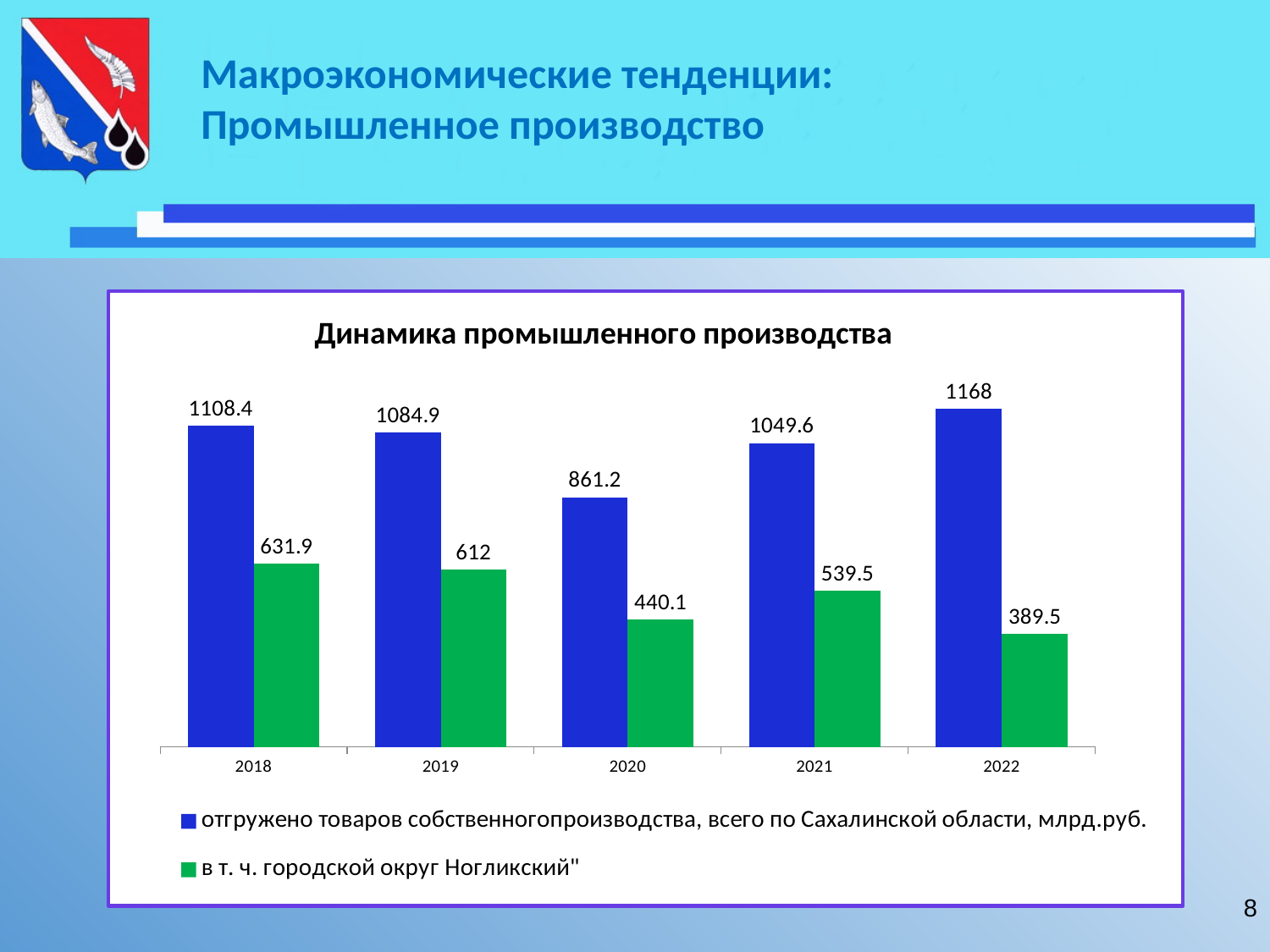
Does the value for городской округ Ногликский rise or fall from 2018 to 2020? fall In which year is the Sakhalin region total highest? 2022 What is the title of the chart? Динамика промышленного производства What colour are the bars for городской округ Ногликский? green How many years are shown on the x axis? 5 What kind of chart is shown on the slide? bar chart Which is larger: the Ногликский value in 2019 or in 2020? 2019 In which year is the value for городской округ Ногликский lowest? 2022 What is the value for городской округ Ногликский in 2021? 539.5 What is the difference between the Sakhalin region total and the Ногликский value in 2018? 476.5 What is the value for the Sakhalin region total (отгружено товаров собственного производства, всего по Сахалинской области) in 2020? 861.2 How many series does the legend list? 2